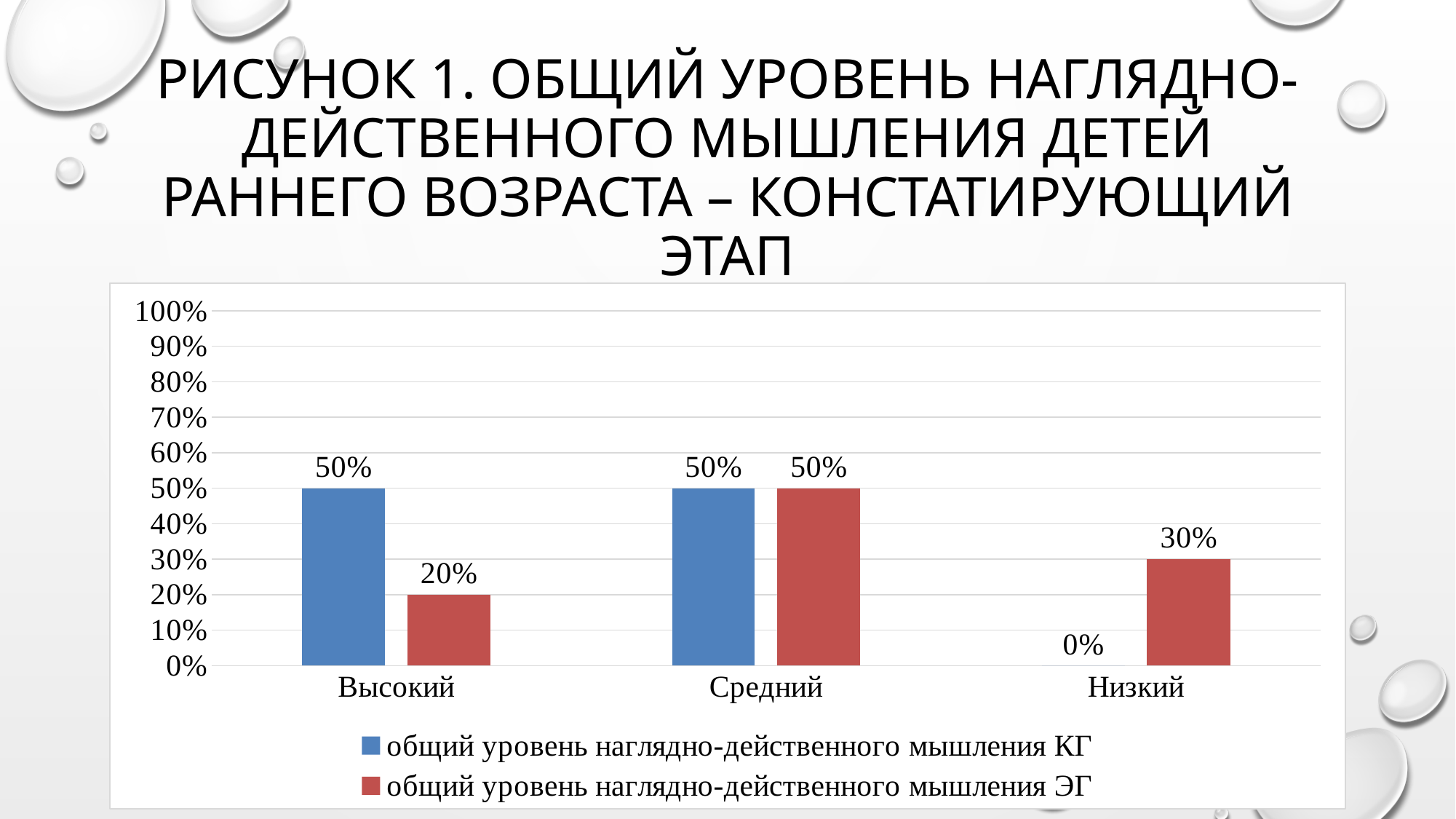
What is the value for ЭГ (red) in the Высокий category? 20% What is the value for КГ (blue) in the Высокий category? 50% In which category is the ЭГ (red) value highest? Средний Which is larger in the Низкий category, the КГ value or the ЭГ value? ЭГ How many series does the legend list? 2 In which category is the ЭГ (red) value lowest? Высокий What kind of chart is shown on the slide? Bar chart How many categories are shown on the x axis? 3 What is the value for ЭГ (red) in the Средний category? 50% What is the value for ЭГ (red) in the Низкий category? 30% What is the value for КГ (blue) in the Низкий category? 0% What is the difference between the КГ and ЭГ values in the Высокий category? 30%